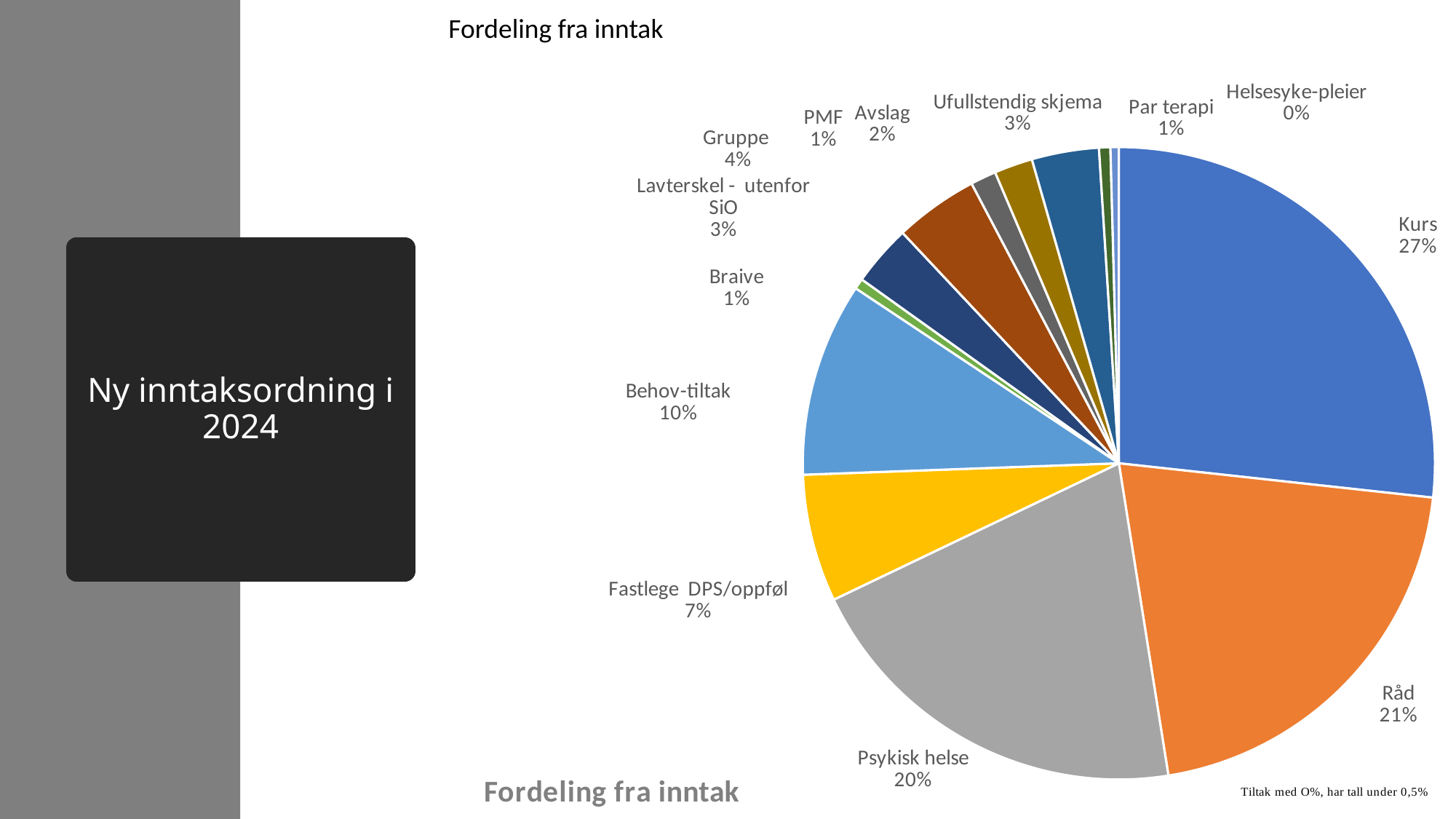
What is the title of the chart? Fordeling fra inntak What is the value shown for Fastlege DPS/oppføl? 7% What is the value shown for Ufullstendig skjema? 3% Which category has the smallest share, shown as 0%? Helsesyke-pleier What share of the pie does Kurs have? 27% How many categories are shown in the pie chart? 13 What is the value shown for Behov-tiltak? 10% What share of the pie does Psykisk helse have? 20% What kind of chart is shown on the slide? pie chart What is the difference in percentage points between Kurs and Råd? 6 Which is larger, the share for Gruppe or the share for Avslag? Gruppe Which category has the largest slice of the pie? Kurs